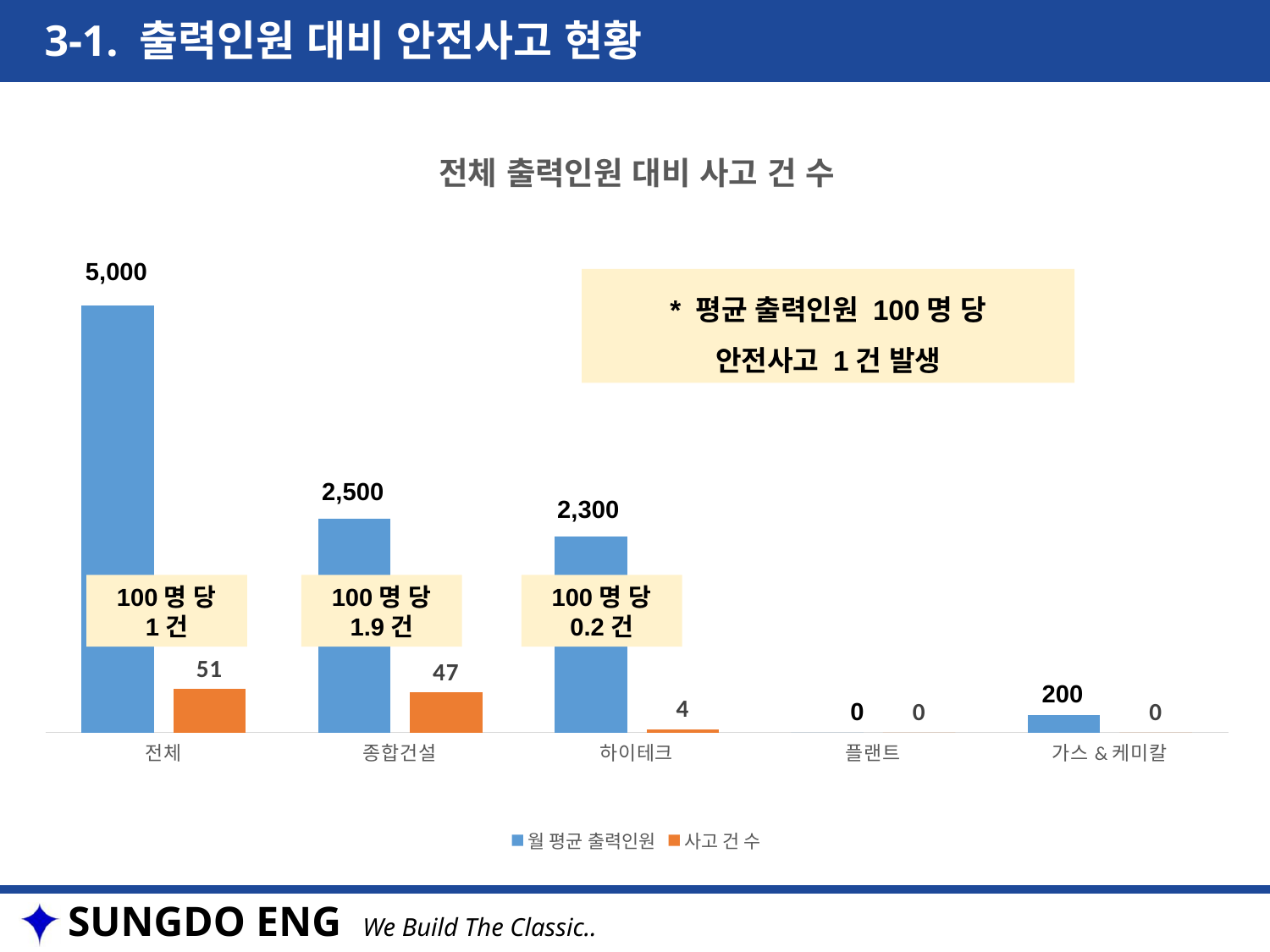
Which category has the lowest 월 평균 출력인원? 플랜트 What is the difference between the 월 평균 출력인원 values for 종합건설 and 하이테크? 200 What is the 사고 건 수 value for 종합건설? 47 What is the 월 평균 출력인원 value for 가스 & 케미칼? 200 How many categories are shown on the x axis of the chart? 5 What type of chart is shown on the slide? Bar chart Which is larger, the 사고 건 수 for 종합건설 or for 하이테크? 종합건설 What is the difference between the 사고 건 수 values for 전체 and 종합건설? 4 Which category has the highest 사고 건 수? 전체 What is the 월 평균 출력인원 value for 전체? 5,000 What is the 월 평균 출력인원 value for 하이테크? 2,300 How many series does the legend list? 2